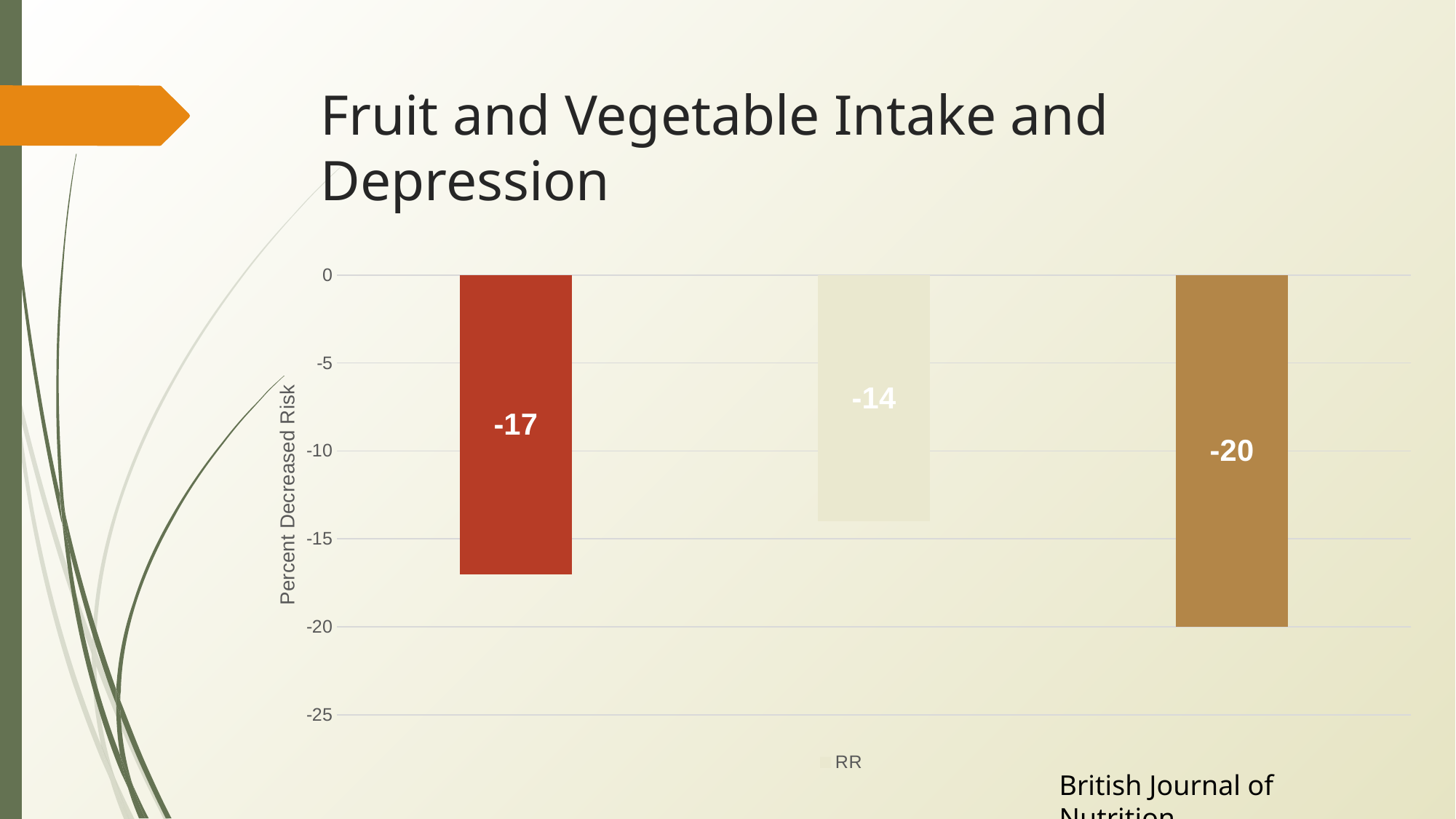
Which bar shows the smallest percent decrease in risk (the value closest to zero)? The middle bar (-14) What is the difference between the values of the rightmost bar and the middle bar? 6 What is the label of the vertical axis? Percent Decreased Risk What kind of chart is shown on the slide? Bar chart Which bar shows the largest percent decrease in risk (the most negative value)? The rightmost bar (-20) Which bar extends further below zero, the leftmost bar or the rightmost bar? The rightmost bar What value is shown on the middle bar? -14 What value is shown on the leftmost (red) bar? -17 What value is shown on the rightmost (brown) bar? -20 How many series does the legend list? 1 What is the difference between the values of the leftmost bar and the middle bar? 3 How many bars are plotted in the chart? 3